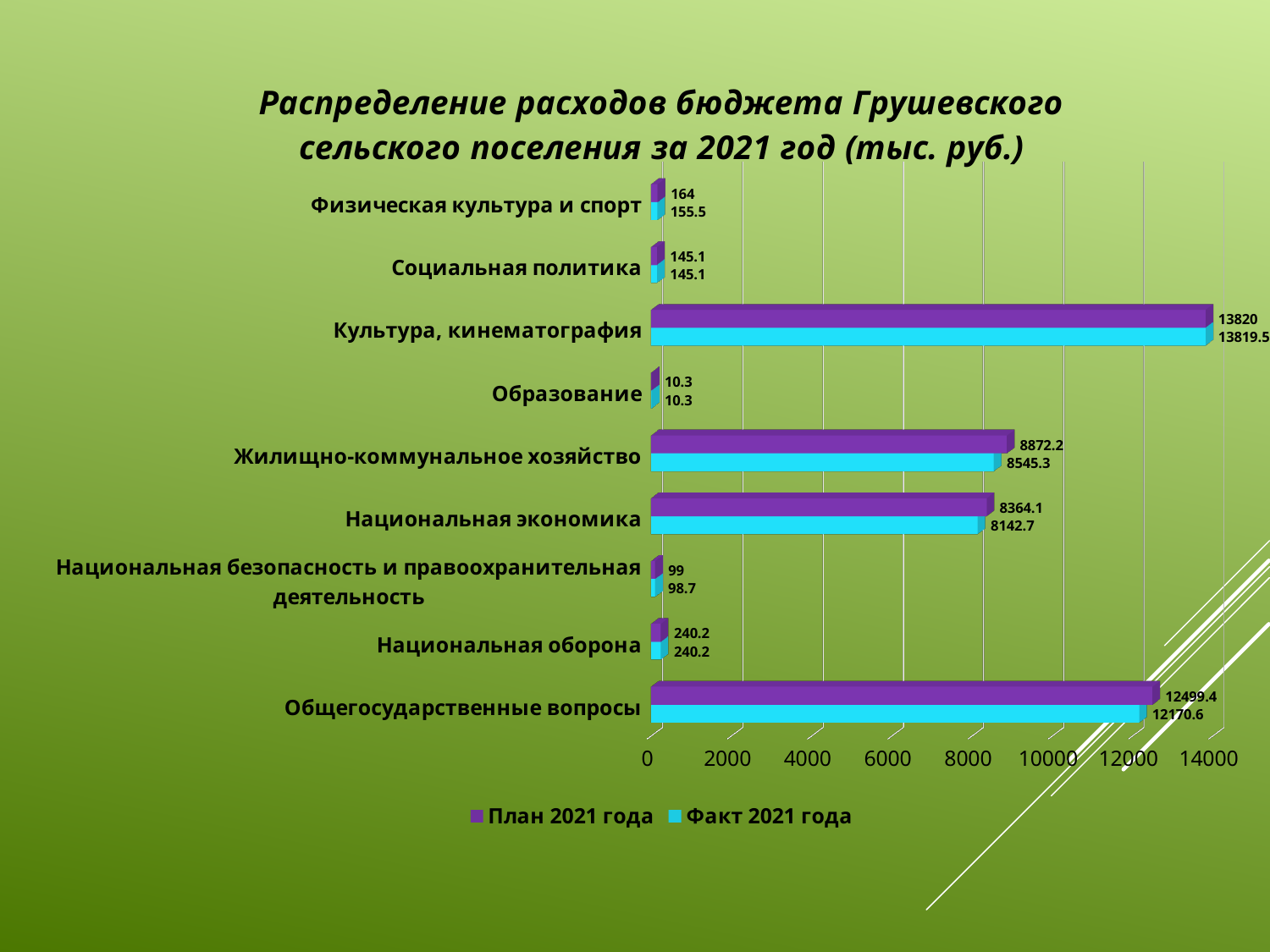
Is the План 2021 года value for Общегосударственные вопросы greater or less than 12000? greater What is the difference between the План 2021 года and Факт 2021 года values for Общегосударственные вопросы? 328.8 What is the difference between the План 2021 года and Факт 2021 года values for Национальная экономика? 221.4 Which category has the lowest Факт 2021 года value? Образование How many series does the legend list? 2 Which is larger: the Факт 2021 года value for Жилищно-коммунальное хозяйство or for Национальная экономика? Жилищно-коммунальное хозяйство How many categories are shown on the chart? 9 What is the Факт 2021 года value for Общегосударственные вопросы? 12170.6 What kind of chart is shown on the slide? bar chart What is the План 2021 года value for Культура, кинематография? 13820 Which category has the highest План 2021 года value? Культура, кинематография What is the Факт 2021 года value for Жилищно-коммунальное хозяйство? 8545.3